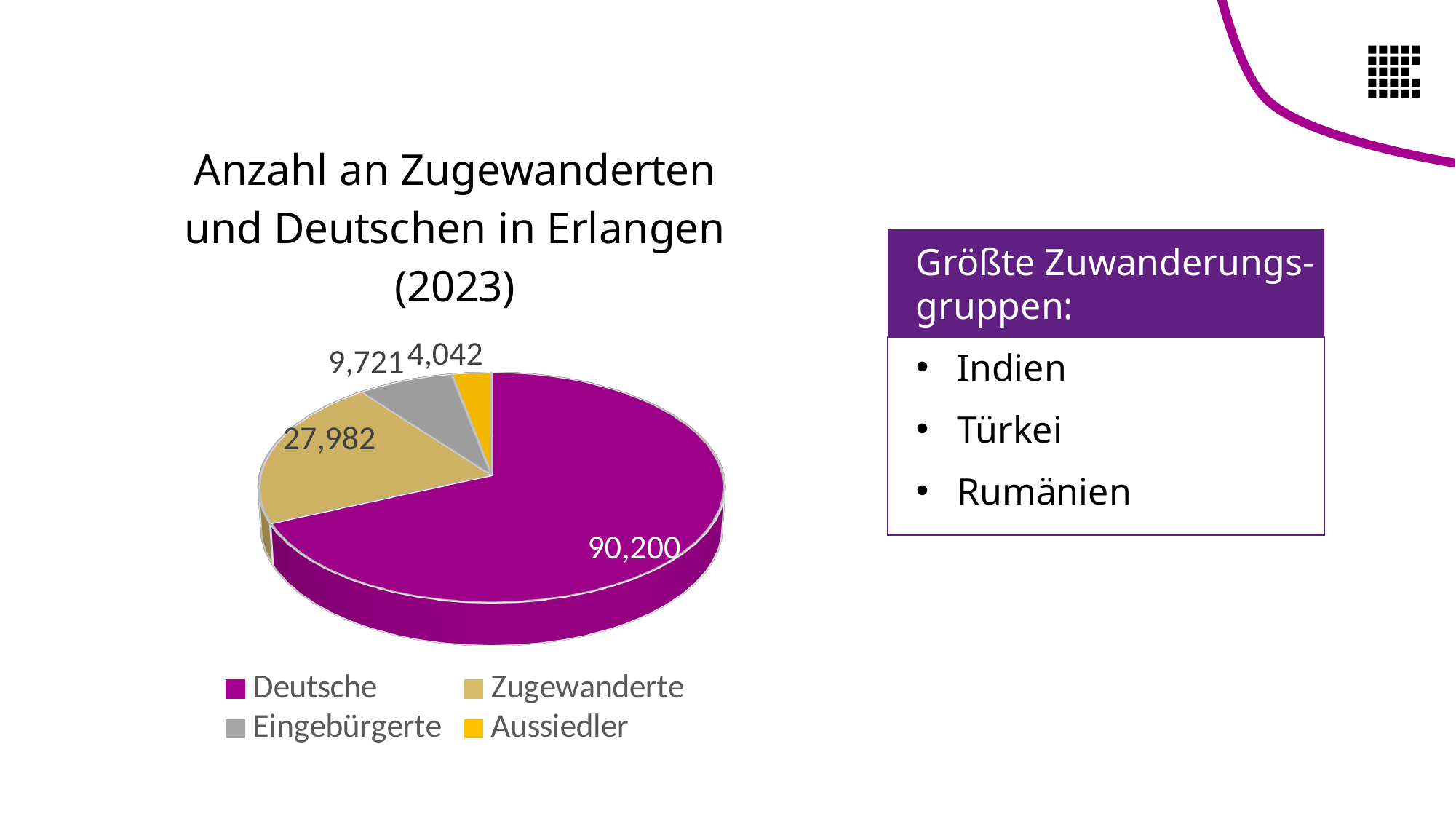
Which category has the largest slice in the pie chart? Deutsche Which category has the smallest slice in the pie chart? Aussiedler What kind of chart is shown on the slide? Pie chart How many categories does the pie chart show? 4 What is the difference between the values for Deutsche and Zugewanderte? 62,218 Which is larger, the value for Zugewanderte or the value for Eingebürgerte? Zugewanderte What is the title of the chart? Anzahl an Zugewanderten und Deutschen in Erlangen (2023) What is the value for Eingebürgerte in the pie chart? 9,721 What is the value for Aussiedler in the pie chart? 4,042 What is the value for Deutsche in the pie chart? 90,200 What is the difference between the values for Eingebürgerte and Aussiedler? 5,679 What is the value for Zugewanderte in the pie chart? 27,982